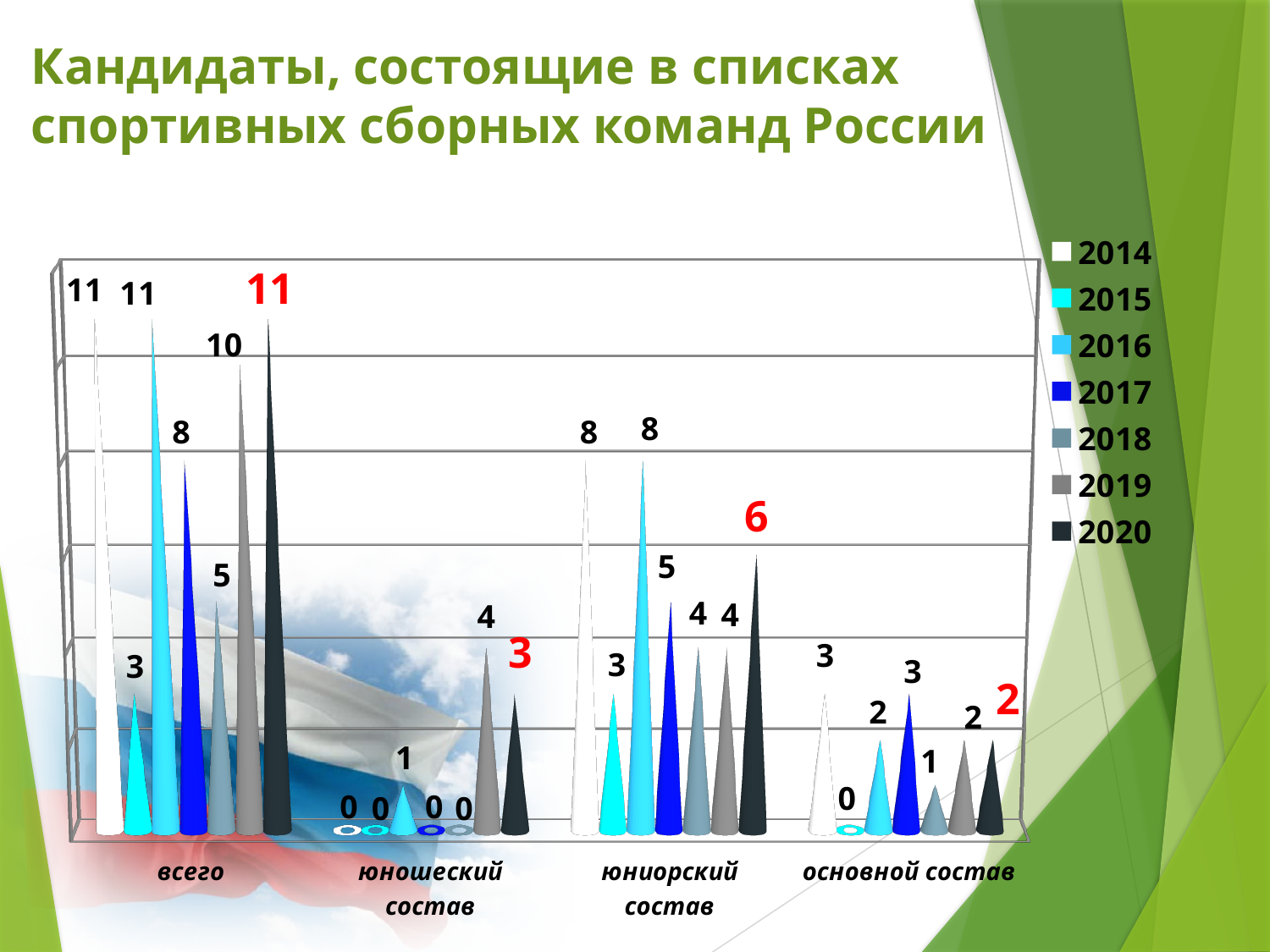
What is the value for 2020 in the 'всего' category? 11 How many categories are shown on the x axis? 4 Which is larger in the 'основной состав' category: the value for 2014 or the value for 2016? 2014 What is the difference between the 2016 and 2020 values in the 'юниорский состав' category? 2 Which year has the highest value in the 'юношеский состав' category? 2019 Which year has the lowest value in the 'всего' category? 2015 What is the value for 2018 in the 'основной состав' category? 1 How many series does the legend list? 7 Which year is shown in dark grey in the legend? 2020 What is the value for 2019 in the 'юношеский состав' category? 4 What is the value for 2017 in the 'юниорский состав' category? 5 What kind of chart is shown on the slide? bar chart